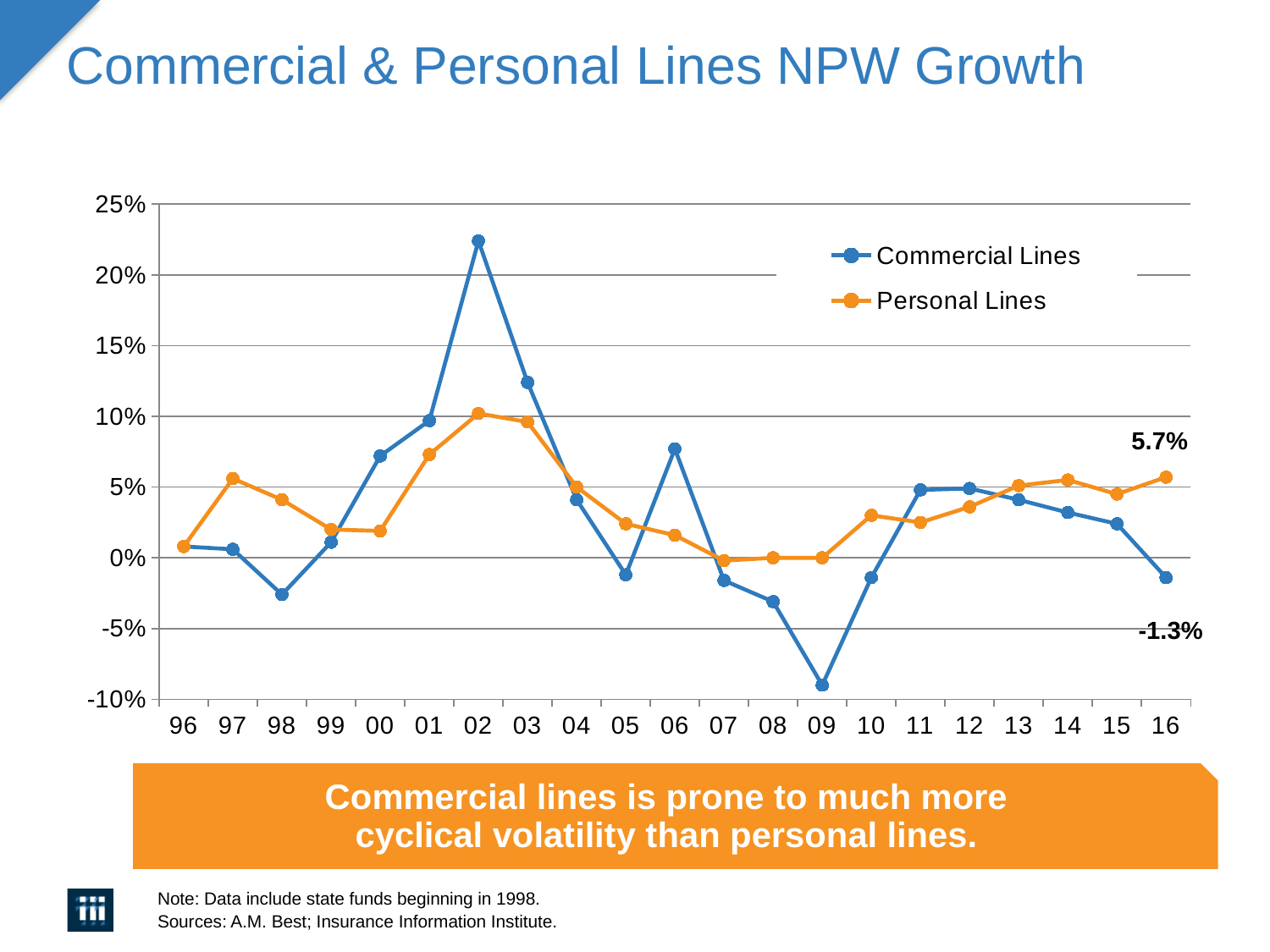
Is the Commercial Lines value for 09 greater or less than -5%? less In 16, which series has the higher value, Commercial Lines or Personal Lines? Personal Lines What is the difference between the Personal Lines and Commercial Lines values labelled for 16? 7.0 percentage points In which year does the Commercial Lines series reach its highest value? 02 What kind of chart is shown on the slide? Line chart How many series does the legend list? 2 In which year does the Commercial Lines series reach its lowest value? 09 Is the Commercial Lines value for 02 greater or less than 20%? greater What is the Personal Lines NPW growth value labelled for 16? 5.7% How many years are plotted along the x axis? 21 What is the Commercial Lines NPW growth value labelled for 16? -1.3% Does the Commercial Lines series rise or fall from 12 to 16? Fall